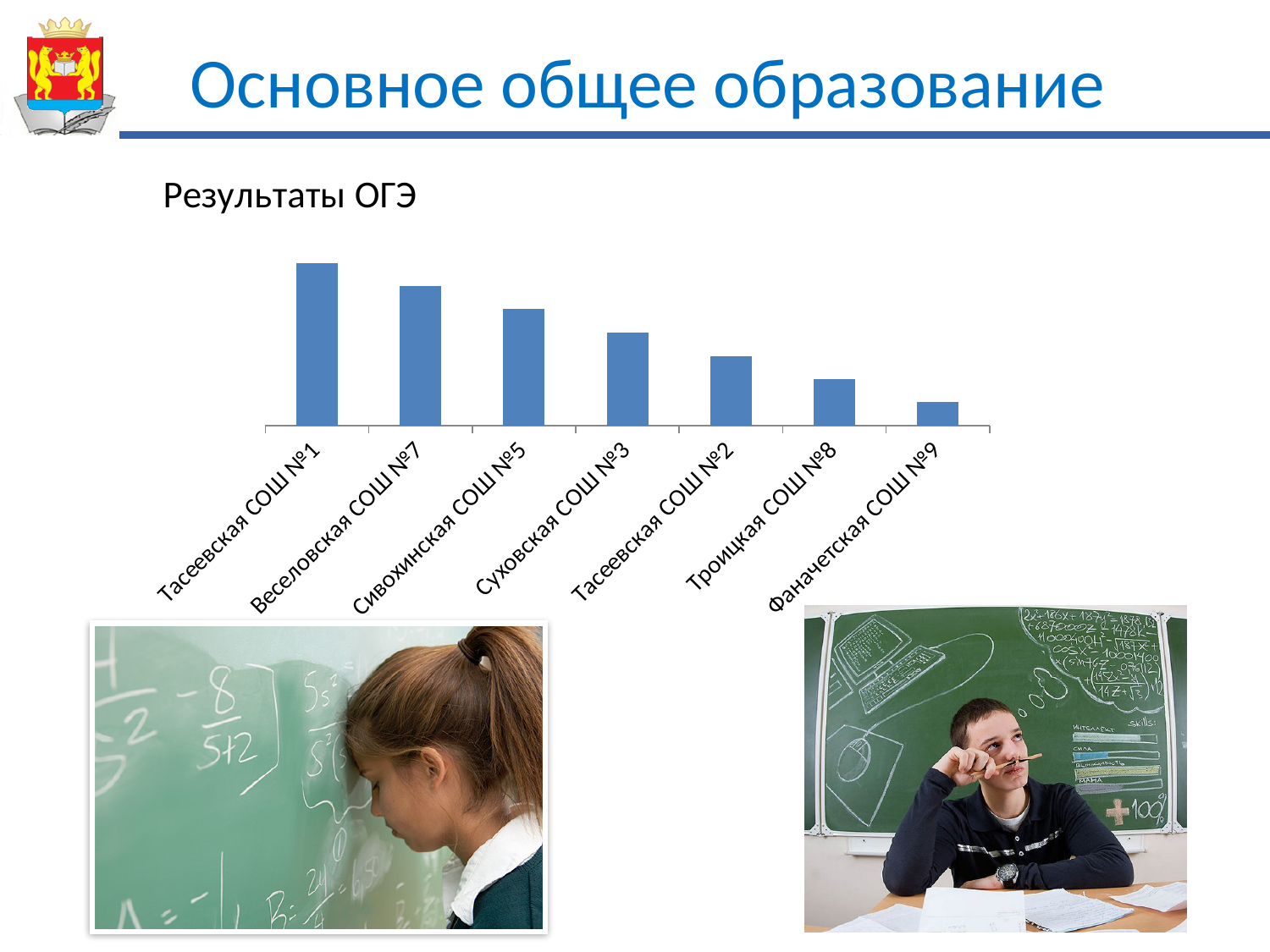
What kind of chart is shown on the slide? Bar chart Which school has the highest bar in the chart? Тасеевская СОШ №1 What is the heading shown above the chart? Результаты ОГЭ Which school is plotted first (leftmost) on the x axis? Тасеевская СОШ №1 Which has the smaller value: Сивохинская СОШ №5 or Фаначетская СОШ №9? Фаначетская СОШ №9 Which has the larger value: Веселовская СОШ №7 or Суховская СОШ №3? Веселовская СОШ №7 Which school has the lowest bar in the chart? Фаначетская СОШ №9 Which has the larger value: Троицкая СОШ №8 or Тасеевская СОШ №2? Тасеевская СОШ №2 How many schools (categories) are plotted in the chart? 7 Do the bar values rise or fall from left to right along the x axis? Fall